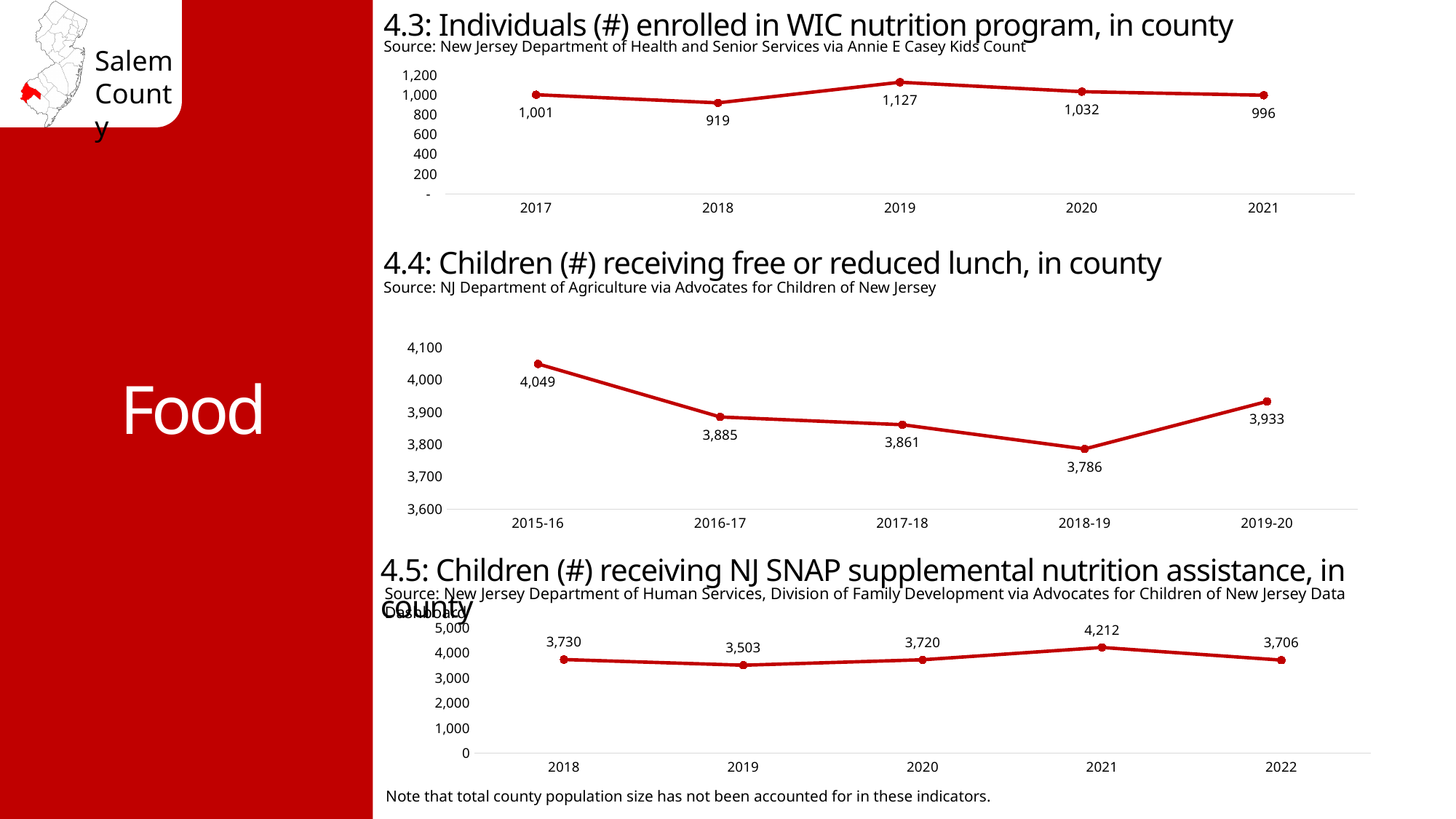
In the chart '4.5: Children (#) receiving NJ SNAP supplemental nutrition assistance, in county', what is the difference between the 2021 and 2022 values? 506 In the chart '4.5: Children (#) receiving NJ SNAP supplemental nutrition assistance, in county', which year has the lowest value? 2019 In the chart '4.3: Individuals (#) enrolled in WIC nutrition program, in county', how many years are plotted? 5 In the chart '4.4: Children (#) receiving free or reduced lunch, in county', what kind of chart is shown? line chart In the chart '4.4: Children (#) receiving free or reduced lunch, in county', do the values rise or fall from 2015-16 to 2018-19? fall In the chart '4.4: Children (#) receiving free or reduced lunch, in county', what is the value for 2018-19? 3,786 In the chart '4.4: Children (#) receiving free or reduced lunch, in county', which school year has the highest value? 2015-16 In the chart '4.3: Individuals (#) enrolled in WIC nutrition program, in county', what is the difference between the 2019 and 2018 values? 208 In the chart '4.3: Individuals (#) enrolled in WIC nutrition program, in county', what is the value for 2019? 1,127 In the chart '4.5: Children (#) receiving NJ SNAP supplemental nutrition assistance, in county', what is the value for 2021? 4,212 In the chart '4.4: Children (#) receiving free or reduced lunch, in county', is the value for 2016-17 larger or smaller than the value for 2019-20? smaller In the chart '4.3: Individuals (#) enrolled in WIC nutrition program, in county', which year has the lowest value? 2018